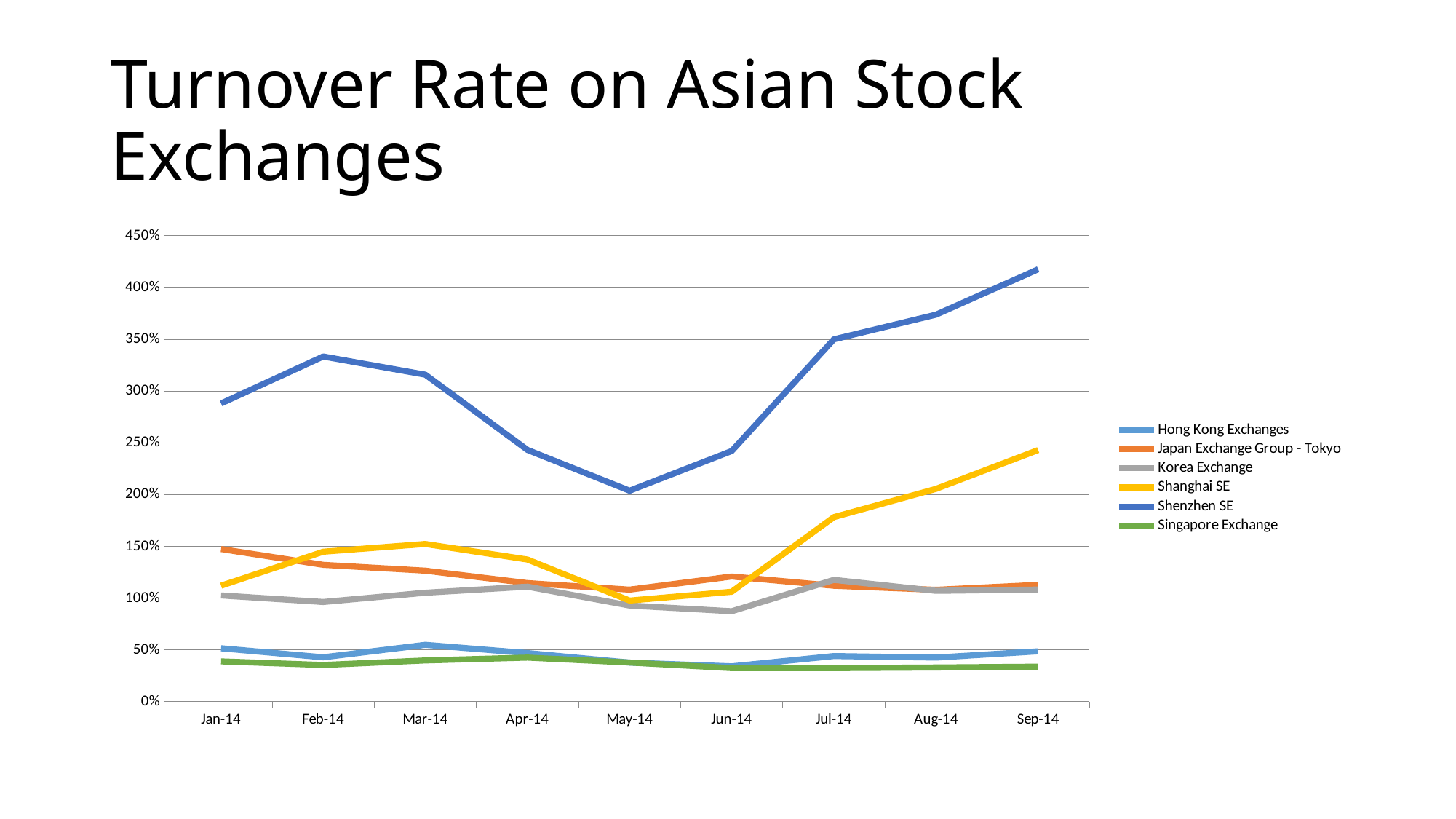
Is the value for Shenzhen SE in Sep-14 greater or less than 400%? greater In which month is the Shenzhen SE turnover rate at its highest? Sep-14 Is the value for Shenzhen SE in May-14 greater or less than 250%? less Which exchange has the highest turnover rate in Sep-14? Shenzhen SE In Jan-14, which is higher: Japan Exchange Group - Tokyo or Shanghai SE? Japan Exchange Group - Tokyo How many months are plotted along the x axis? 9 Which exchange has the lowest turnover rate in Sep-14? Singapore Exchange Does the Shanghai SE turnover rate rise or fall from May-14 to Sep-14? rise Is the value for Shanghai SE in Sep-14 greater or less than 200%? greater How many series does the legend list? 6 What kind of chart is shown on the slide? line chart In which month is the Shenzhen SE turnover rate at its lowest? May-14